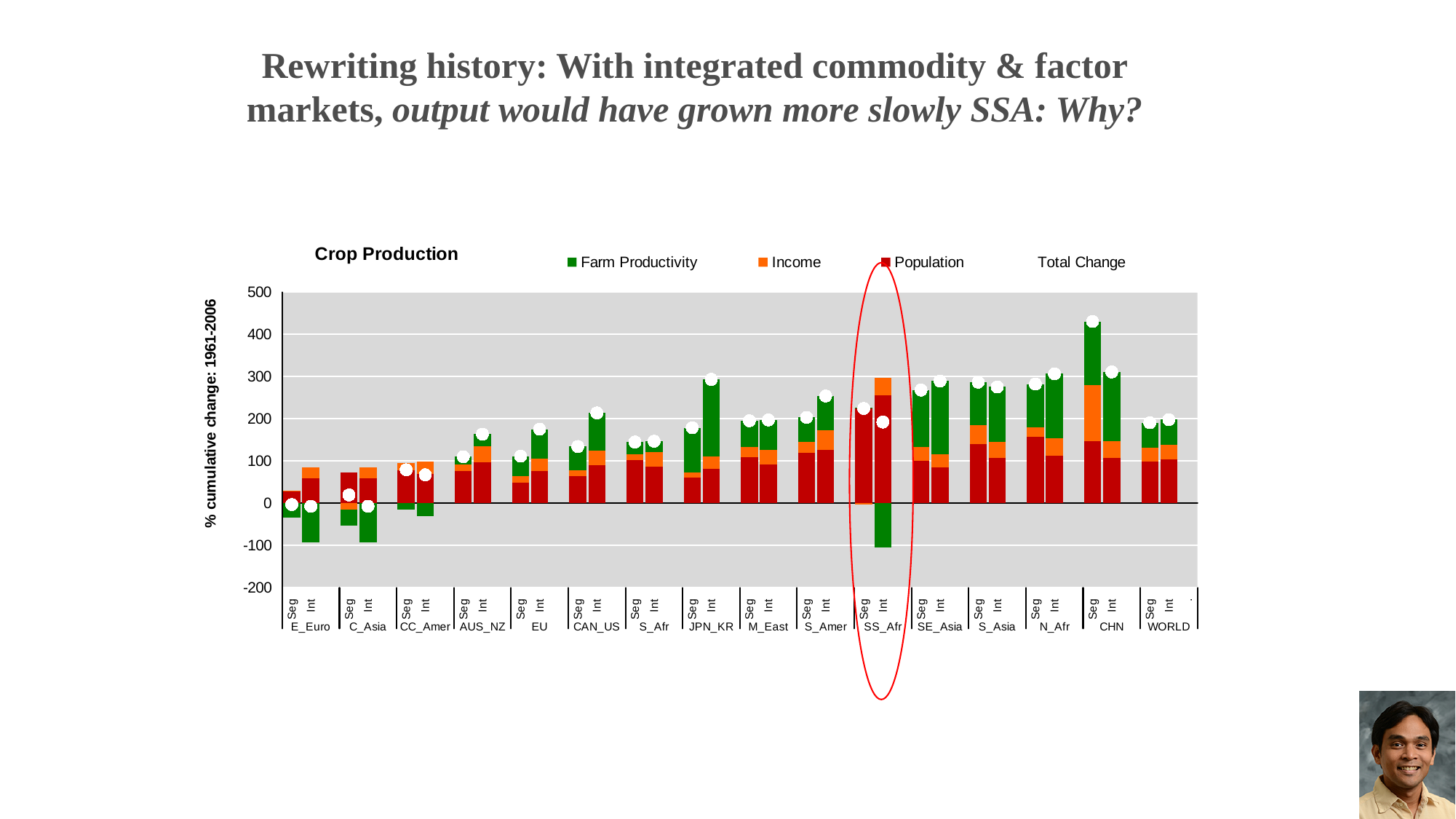
Is the Farm Productivity value for SS_Afr Int greater or less than 0? less How many entries does the chart legend list? 4 How many regions are shown along the x axis of the chart? 16 For SS_Afr, which has the larger Total Change, Seg or Int? Seg Is the Total Change for SE_Asia Seg greater or less than 200? greater What is the title of the chart? Crop Production For JPN_KR, which has the larger Total Change, Seg or Int? Int Which region has the highest Total Change marker in the chart? CHN (Seg) What type of chart is shown on the slide? Stacked bar chart Is the Total Change for CHN Seg greater or less than 400? greater Which region is circled in red on the chart? SS_Afr